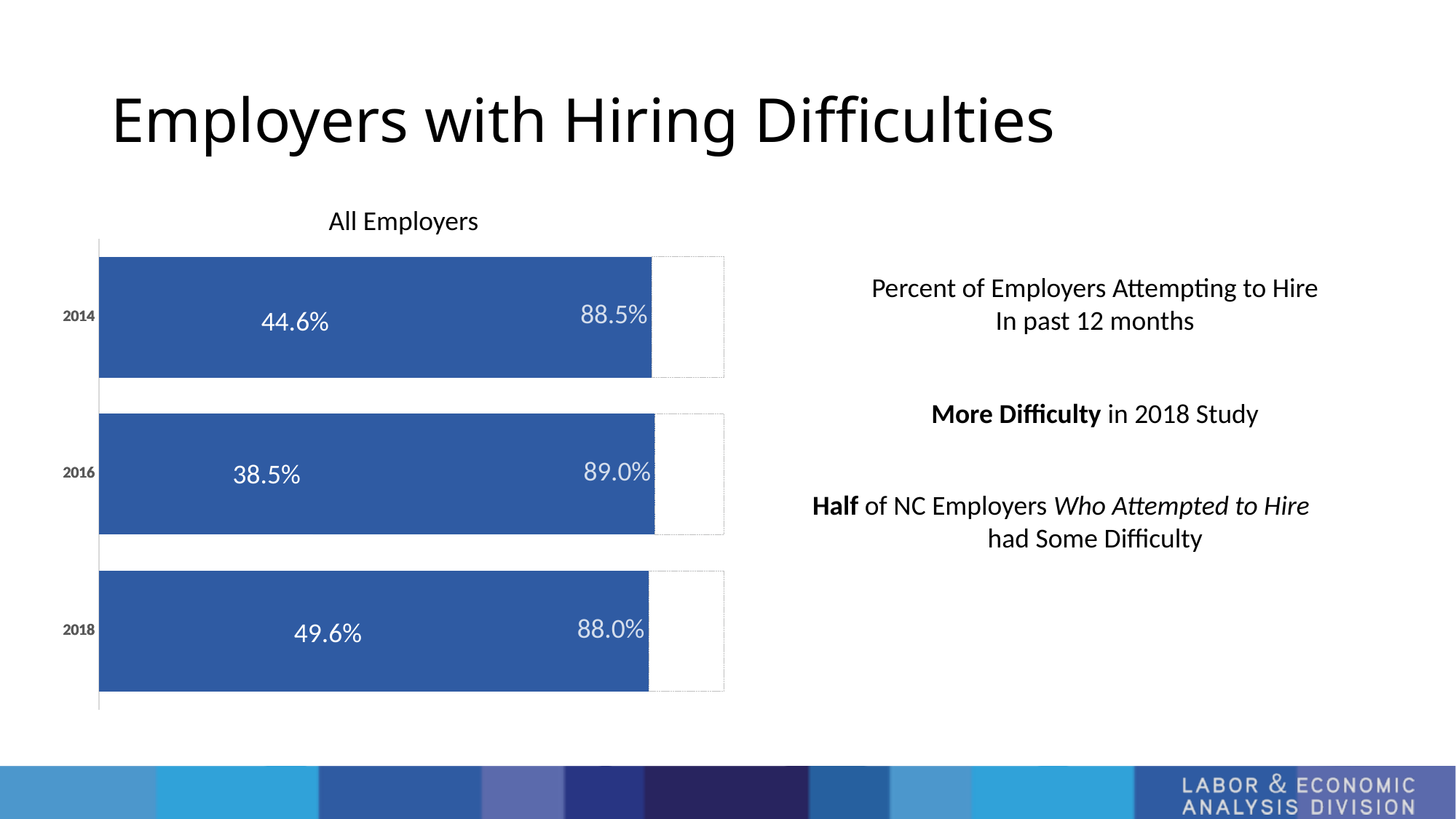
What value is printed at the right end of the 2014 bar? 88.5% What is the smaller value printed inside the 2016 bar? 38.5% What value is printed at the right end of the 2016 bar? 89.0% What is the smaller value printed inside the 2014 bar? 44.6% What is the difference between the inner value for 2018 (49.6%) and the inner value for 2016 (38.5%)? 11.1 percentage points What value is printed at the right end of the 2018 bar? 88.0% What is the smaller value printed inside the 2018 bar? 49.6% What type of chart is shown on the slide? bar chart Which year has the highest of the smaller (inner) values printed on the bars? 2018 Which year has the lowest of the smaller (inner) values printed on the bars? 2016 How many years (categories) are shown in the chart? 3 What is the title of the chart on the slide? All Employers